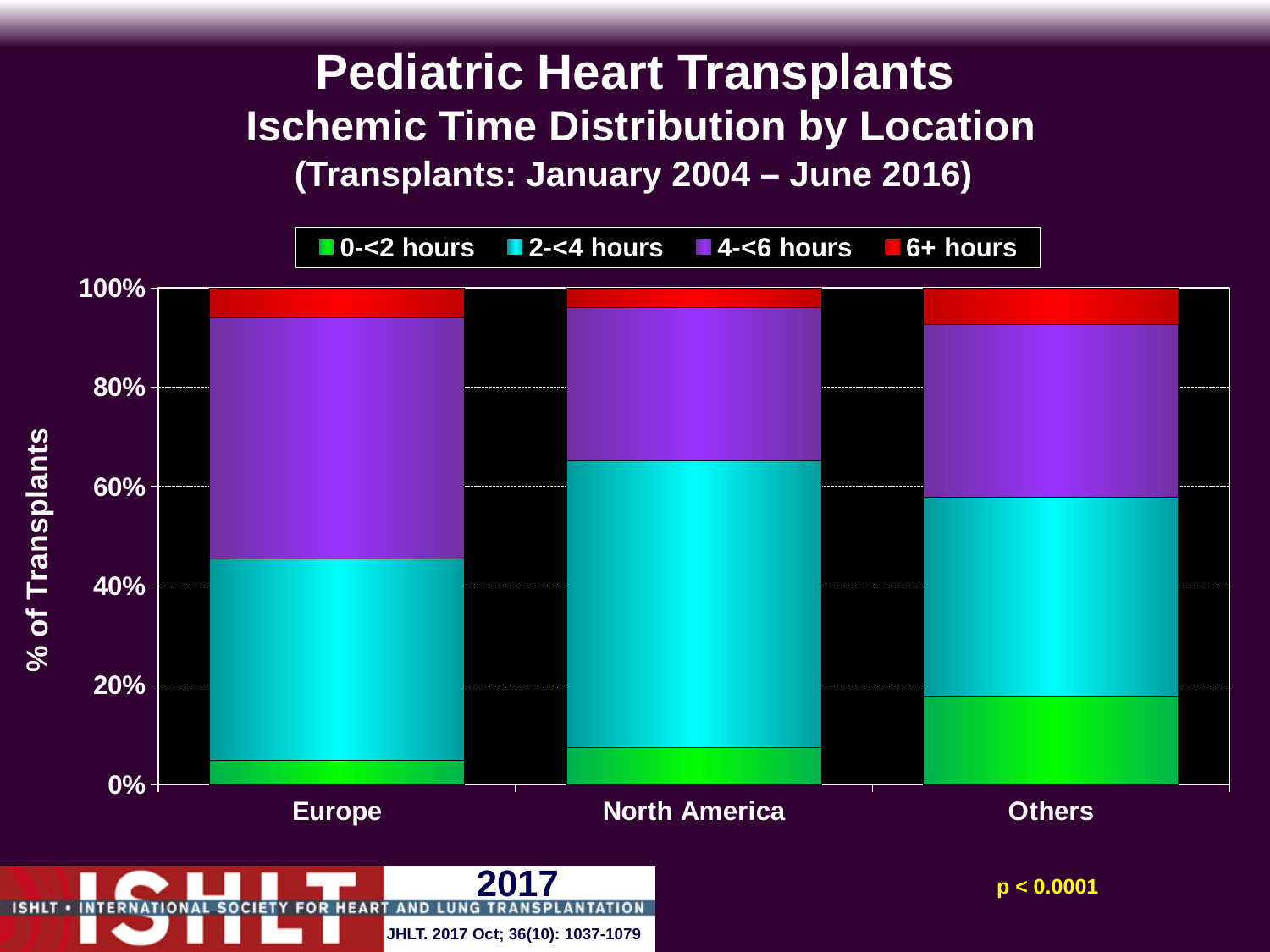
Which location has the largest 4-<6 hours segment? Europe Is the 0-<2 hours share for Europe greater or less than 20%? less Which location has the largest 2-<4 hours segment? North America What is the total height of the stacked bar for Europe? 100% Which location has the largest 0-<2 hours segment? Others Is the 2-<4 hours segment larger for North America or for Europe? North America Is the 0-<2 hours share for Others greater or less than 10%? greater How many series does the legend list? 4 What is the label on the y axis of the chart? % of Transplants How many locations are shown on the x axis of the chart? 3 Is the 2-<4 hours share for North America greater or less than 40%? greater What kind of chart is shown on the slide? Stacked bar chart